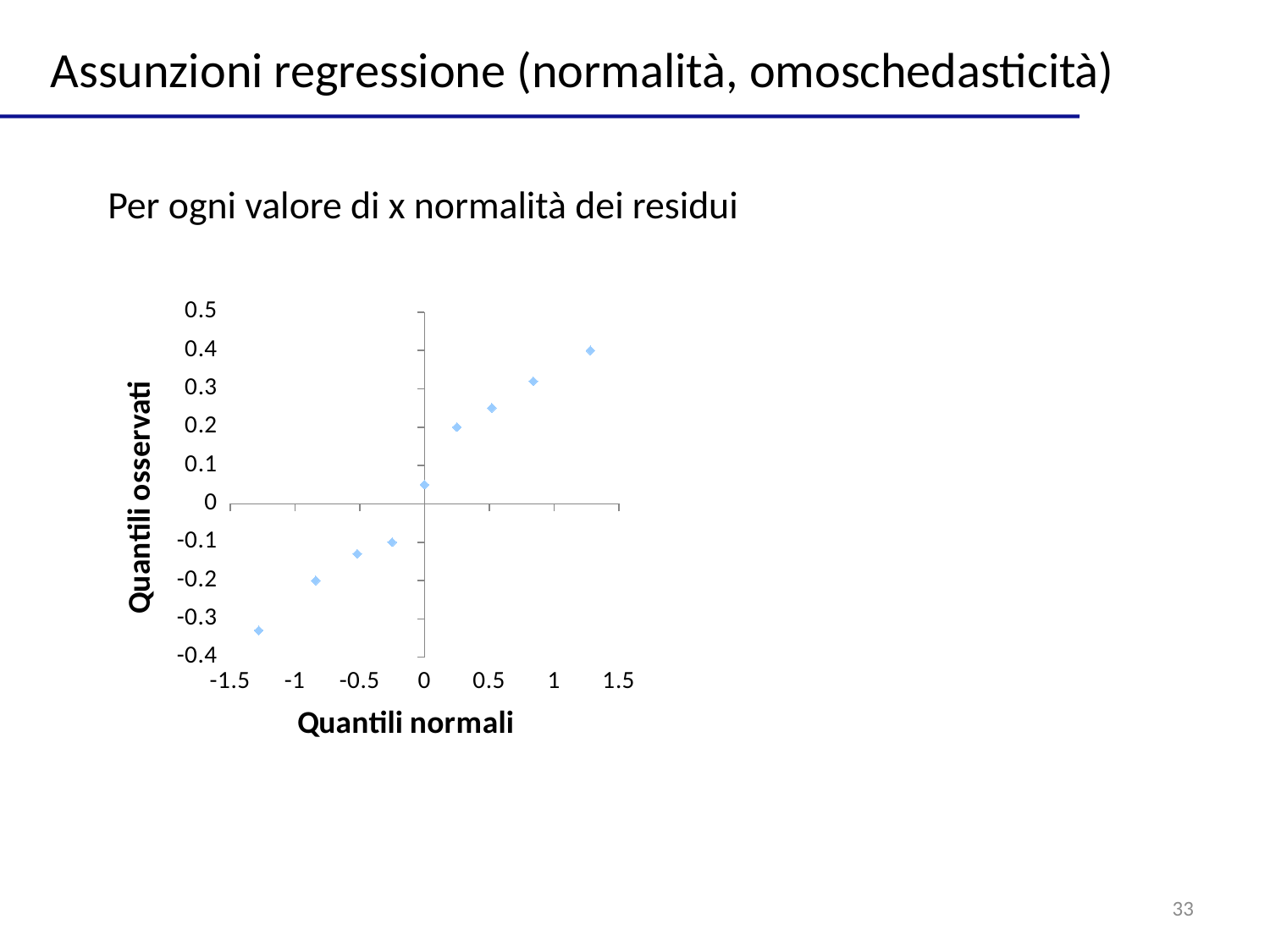
What kind of chart is shown on the slide? scatter plot Is the y value of the point at x = 0 greater or less than 0? greater Which point has the highest y value: the leftmost point or the rightmost point? the rightmost point How many data points are plotted in the chart? 9 Is the y value of the rightmost point (at x = 1.5 side) greater or less than 0.3? greater Is the y value of the point at x = -1 greater or less than 0? less What is the lowest value shown on the y axis of the chart? -0.4 What is the title of the y axis of the chart? Quantili osservati What is the title of the x axis of the chart? Quantili normali Do the plotted values rise or fall as the x axis (Quantili normali) increases? rise